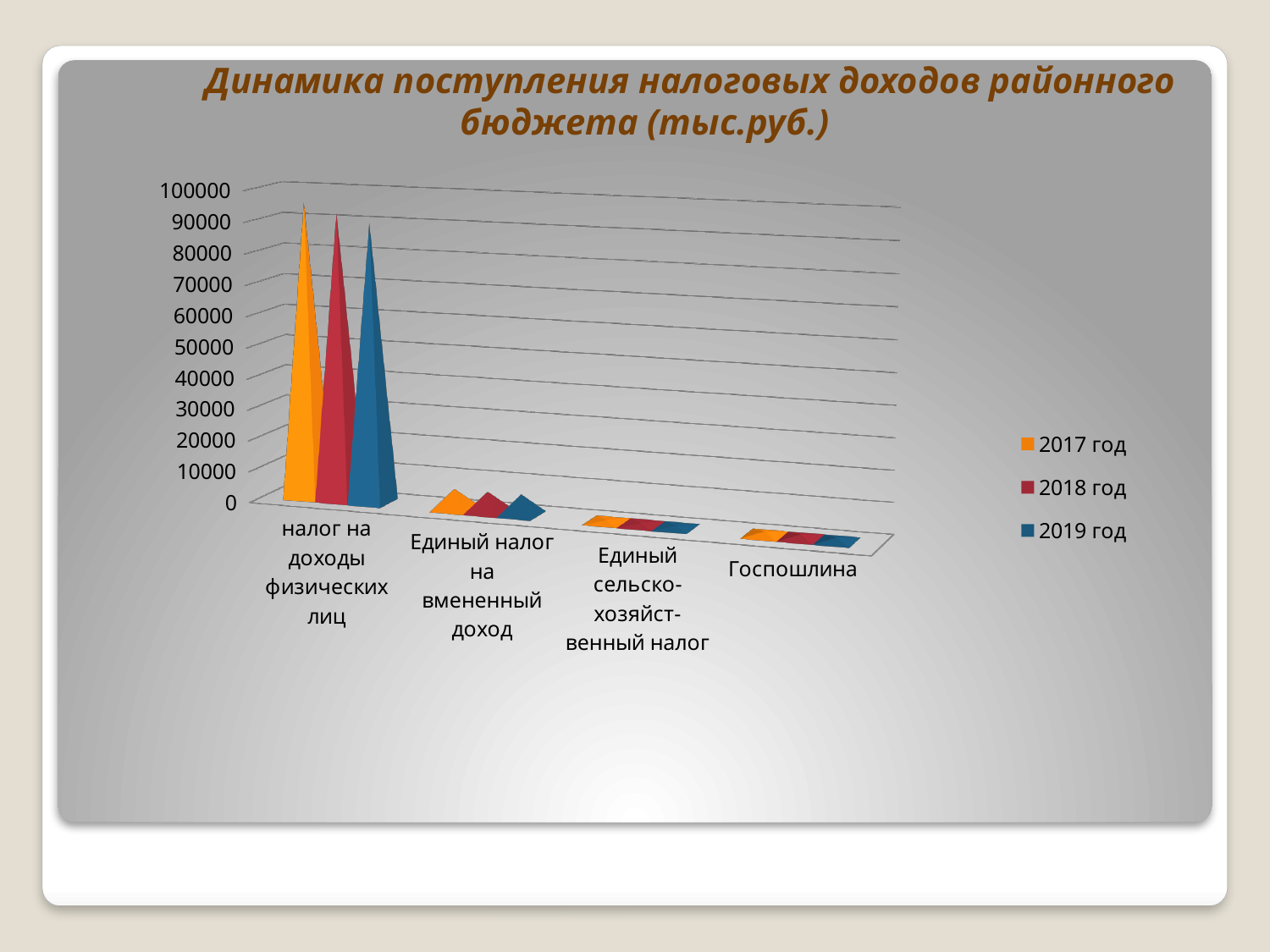
Which category has the highest values in the chart? налог на доходы физических лиц What kind of chart is shown on the slide? bar chart Is the 2019 год value for налог на доходы физических лиц greater or less than 80000? greater Is the 2017 год value for Госпошлина greater or less than 10000? less Is the 2018 год value for Единый налог на вмененный доход greater or less than 10000? less How many series does the chart legend list? 3 Which is larger for 2017 год: налог на доходы физических лиц or Единый налог на вмененный доход? налог на доходы физических лиц Do the values generally rise or fall moving from left to right along the x axis? fall Which colour represents the 2019 год series in the legend? blue What is the title of the chart? Динамика поступления налоговых доходов районного бюджета (тыс.руб.) How many categories are shown on the x axis of the chart? 4